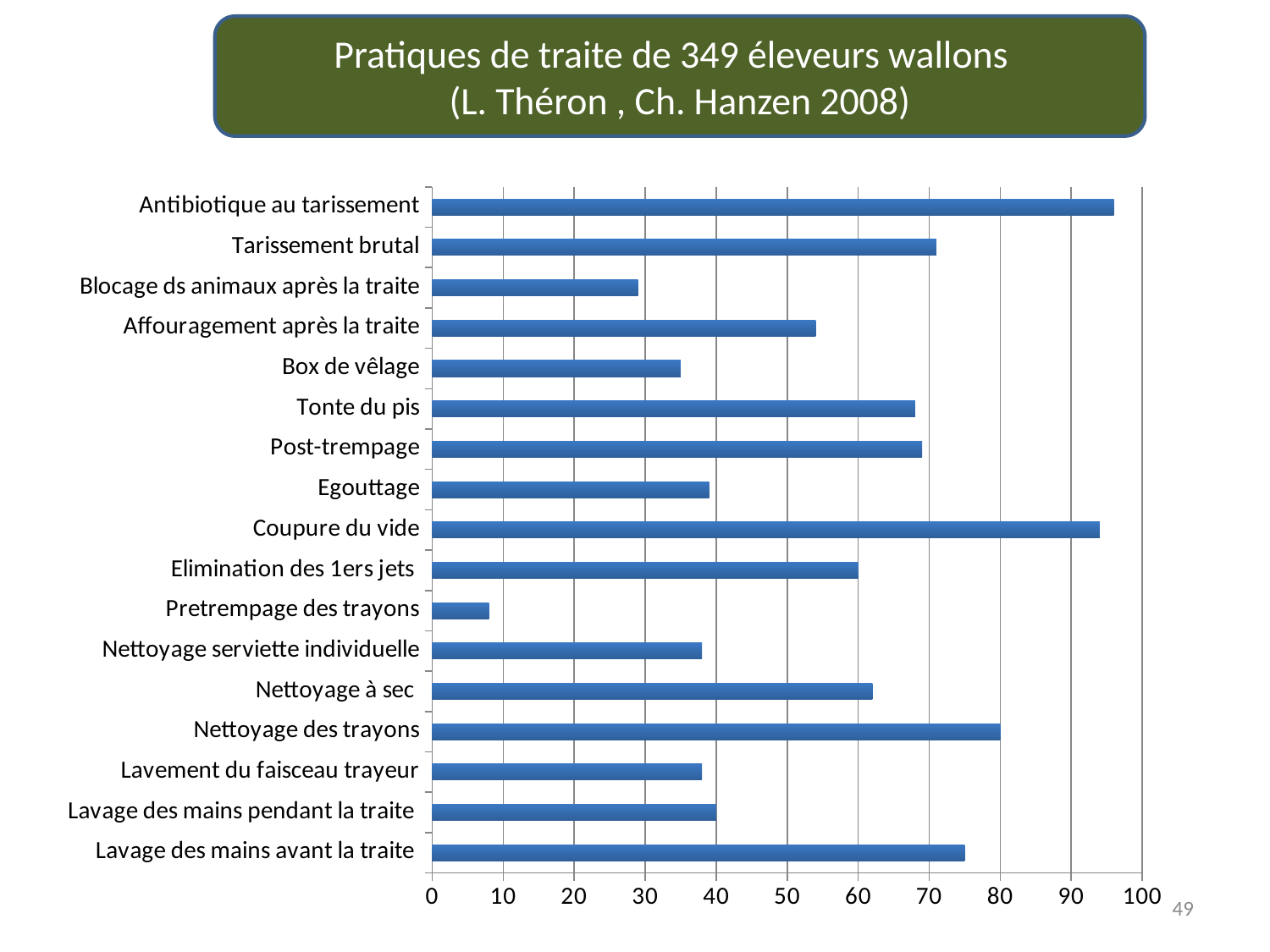
Which has the larger value, Nettoyage des trayons or Nettoyage à sec? Nettoyage des trayons What is the title of the slide containing the chart? Pratiques de traite de 349 éleveurs wallons (L. Théron , Ch. Hanzen 2008) Is the value for Lavage des mains avant la traite greater or less than 70? greater Is the value for Coupure du vide greater or less than 90? greater How many practices (categories) are plotted in the chart? 17 Is the value for Antibiotique au tarissement greater or less than 90? greater Which has the larger value, Tarissement brutal or Blocage ds animaux après la traite? Tarissement brutal Which practice has the lowest value in the chart? Pretrempage des trayons What kind of chart is shown on the slide? bar chart